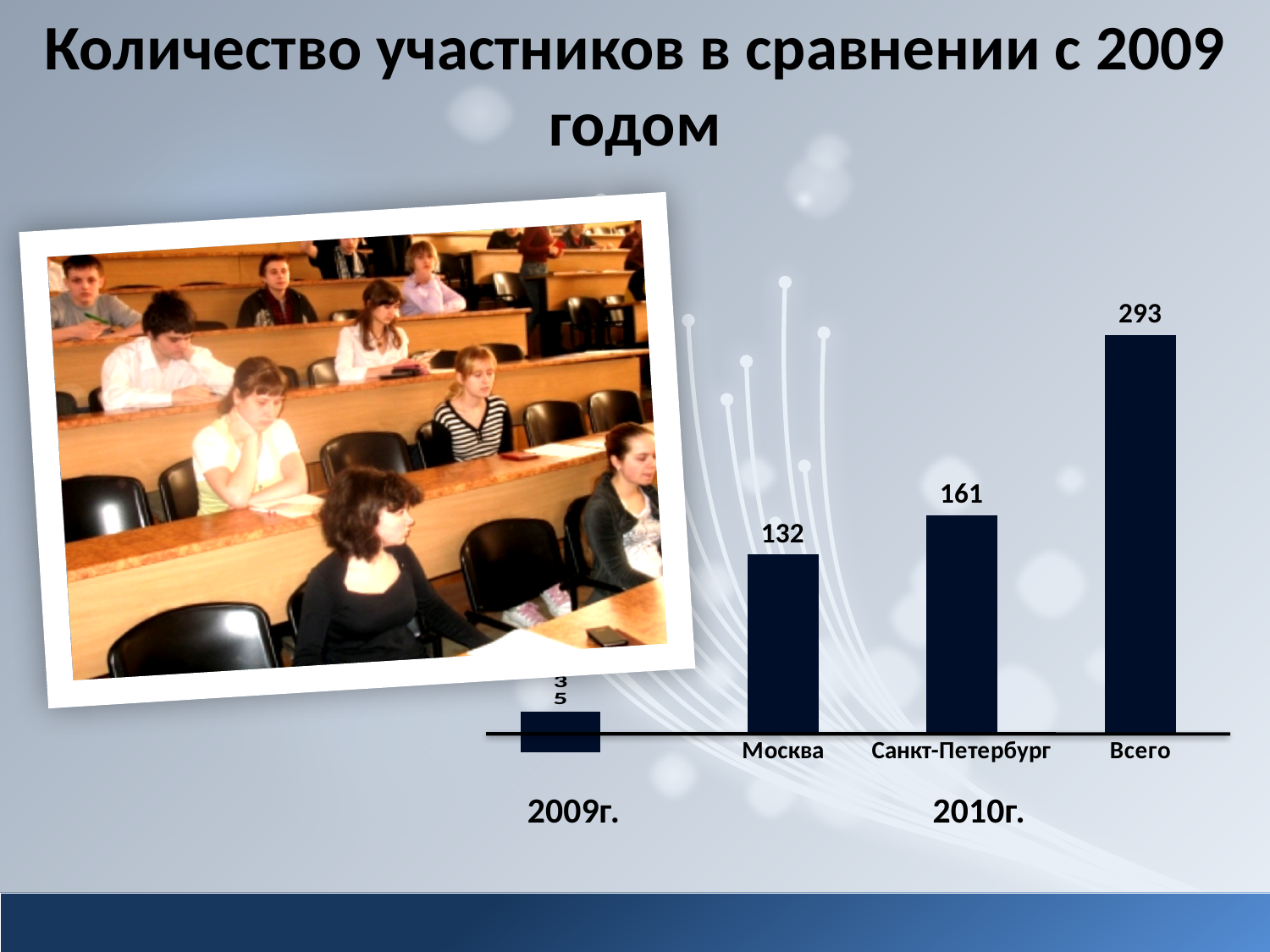
What is the title of the slide containing the chart? Количество участников в сравнении с 2009 годом How many bars are labelled for 2010? 3 Which is larger, the value for Санкт-Петербург or the value for Москва? Санкт-Петербург What type of chart is shown on the slide? bar chart Which two years are compared in the chart? 2009г. and 2010г. What is the value for Санкт-Петербург in 2010? 161 What is the value for Москва in 2010? 132 What is the value for Всего in 2010? 293 Which 2010 city has the lower value, Москва or Санкт-Петербург? Москва Which 2010 category has the highest value? Всего Is the 2009 bar larger or smaller than the Москва bar for 2010? smaller What is the difference between the values for Санкт-Петербург and Москва in 2010? 29